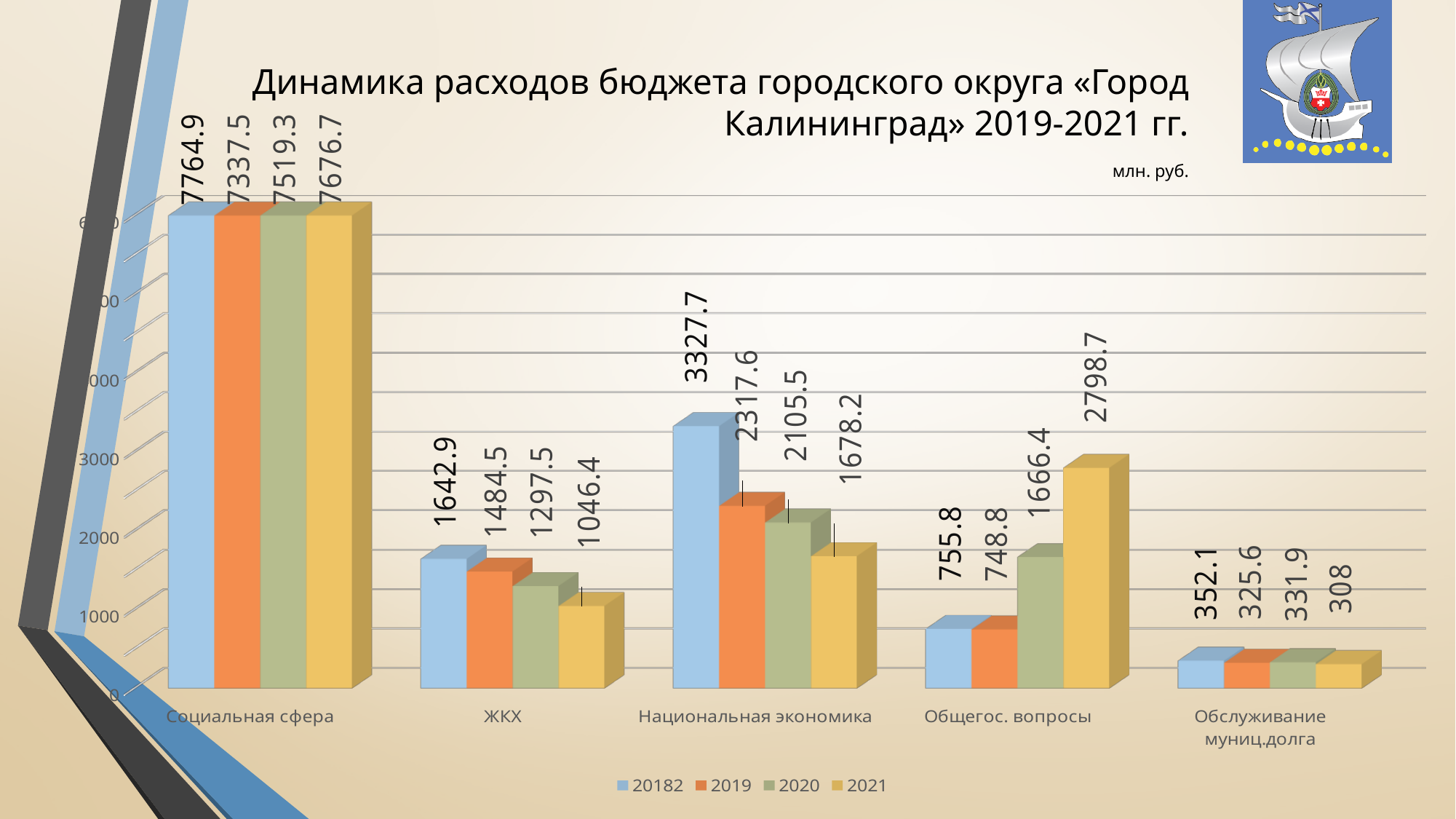
What kind of chart is shown on the slide? bar chart How many series does the legend list? 4 Which category has the lowest 2021 value? Обслуживание муниц.долга How many categories are shown on the x axis? 5 What is the difference between the 2021 and 2020 values for Общегос. вопросы? 1132.3 What is the 2021 value for ЖКХ? 1046.4 What is the 2019 value for Национальная экономика? 2317.6 What is the 2021 value for Обслуживание муниц.долга? 308 Which category has the highest 2020 value? Социальная сфера For Социальная сфера, which is larger: the 2019 value or the 2020 value? 2020 For ЖКХ, do the values rise or fall from the first series to the 2021 series? fall What unit is indicated for the values in the chart? млн. руб.